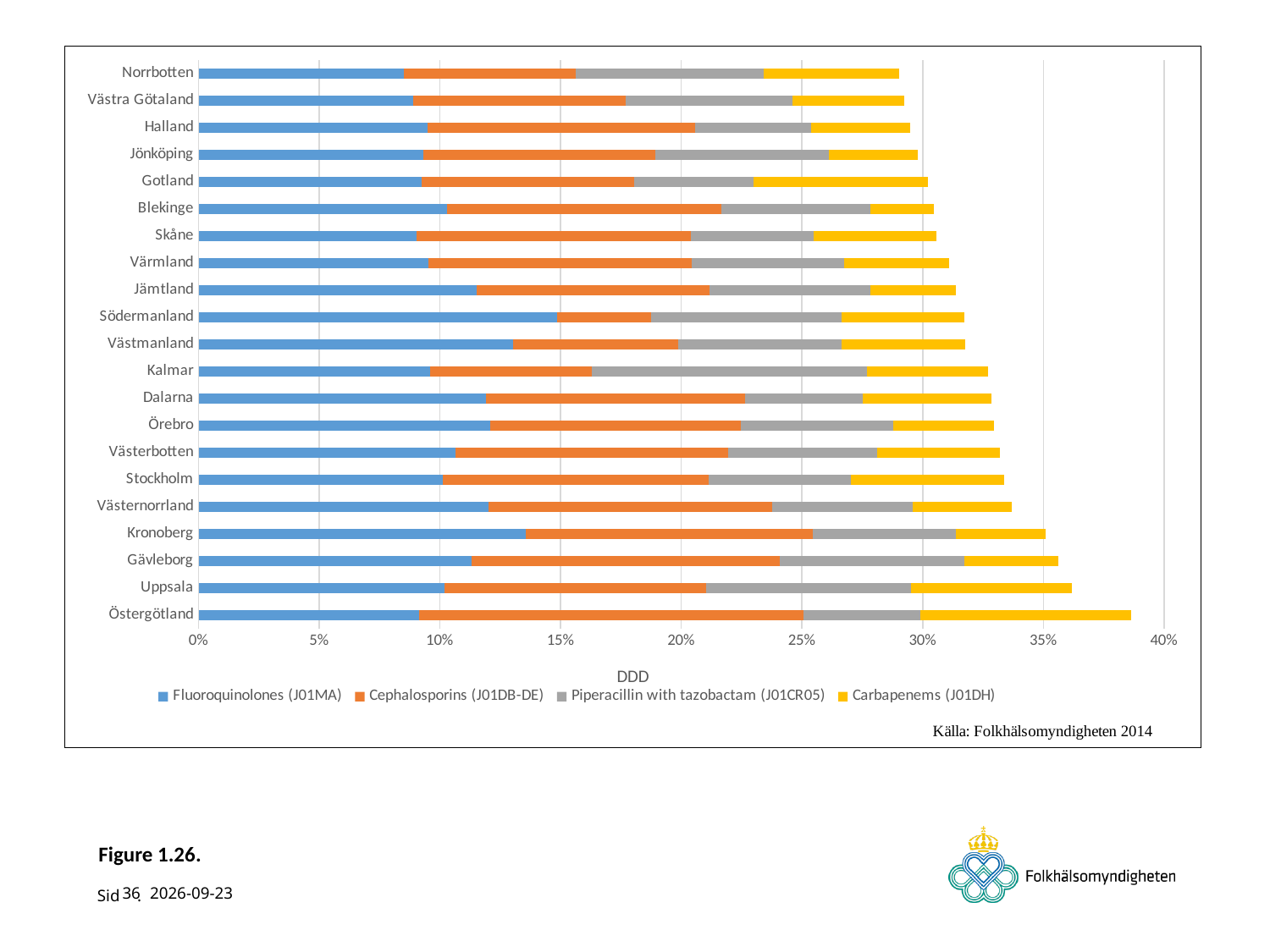
What kind of chart is shown on the slide? Stacked horizontal bar chart Which region has a larger Fluoroquinolones (J01MA) segment, Södermanland or Norrbotten? Södermanland Which series is shown in yellow in the legend? Carbapenems (J01DH) How many regions (categories) are plotted on the chart? 21 Which region has a longer total bar, Östergötland or Norrbotten? Östergötland Is the total bar for Norrbotten greater or less than 30%? less Is the total bar for Östergötland greater or less than 35%? greater Is the total bar for Stockholm greater or less than 35%? less How many series does the legend list? 4 What is the label on the horizontal axis of the chart? DDD Which region has the longest total bar? Östergötland